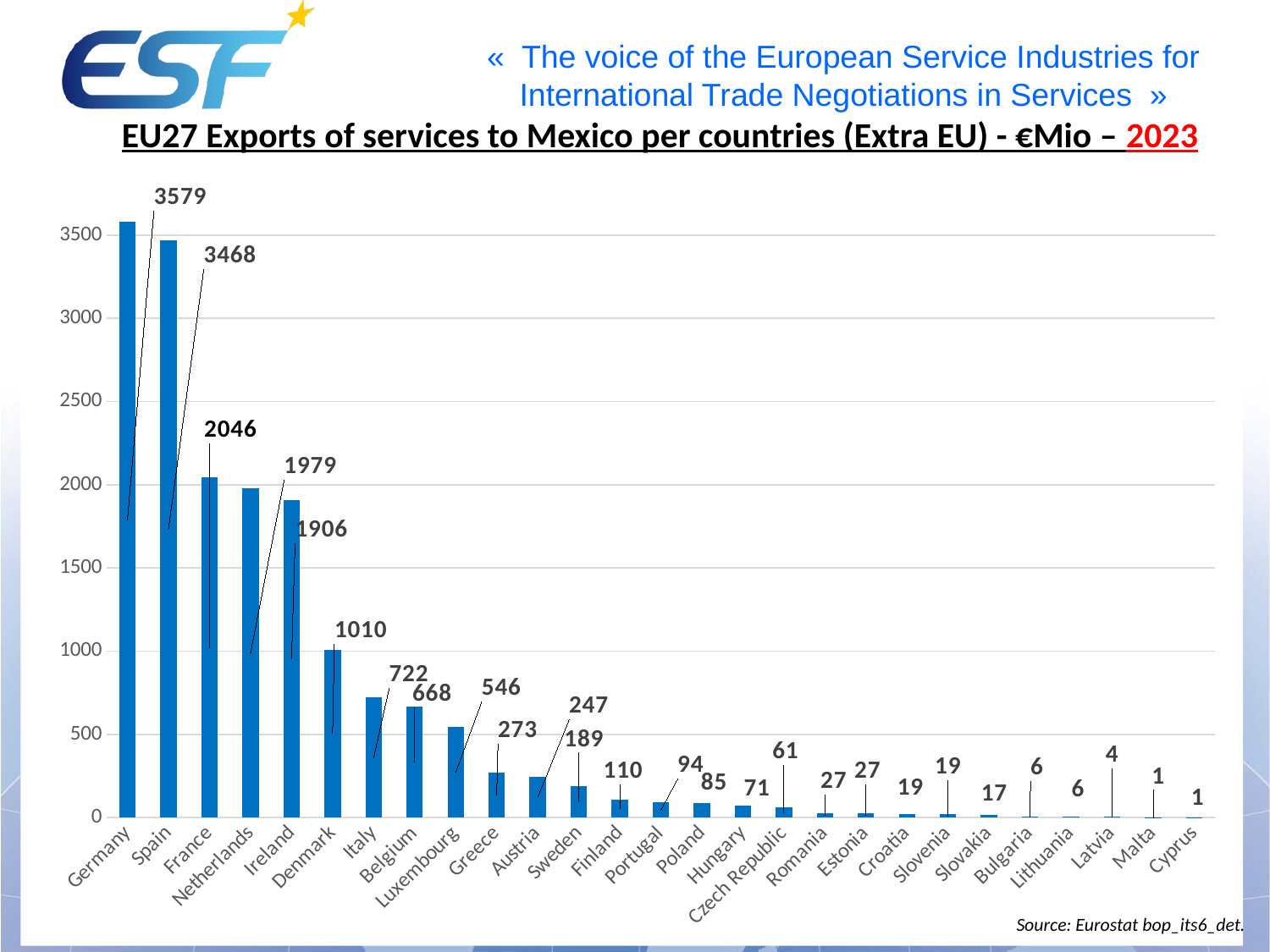
Which is larger, the value for Denmark or the value for Italy? Denmark What is the difference between the values for Italy and Belgium? 54 What kind of chart is shown on the slide? bar chart What is the source cited for the chart? Eurostat bop_its6_det What is the value for Czech Republic? 61 What is the value for Germany? 3579 How many countries are shown on the chart? 27 Which country has the highest value? Germany Is the value for Luxembourg greater or less than 500? greater Do the values rise or fall from left to right along the x axis? fall What is the value for Denmark? 1010 What is the difference between the values for Germany and Spain? 111